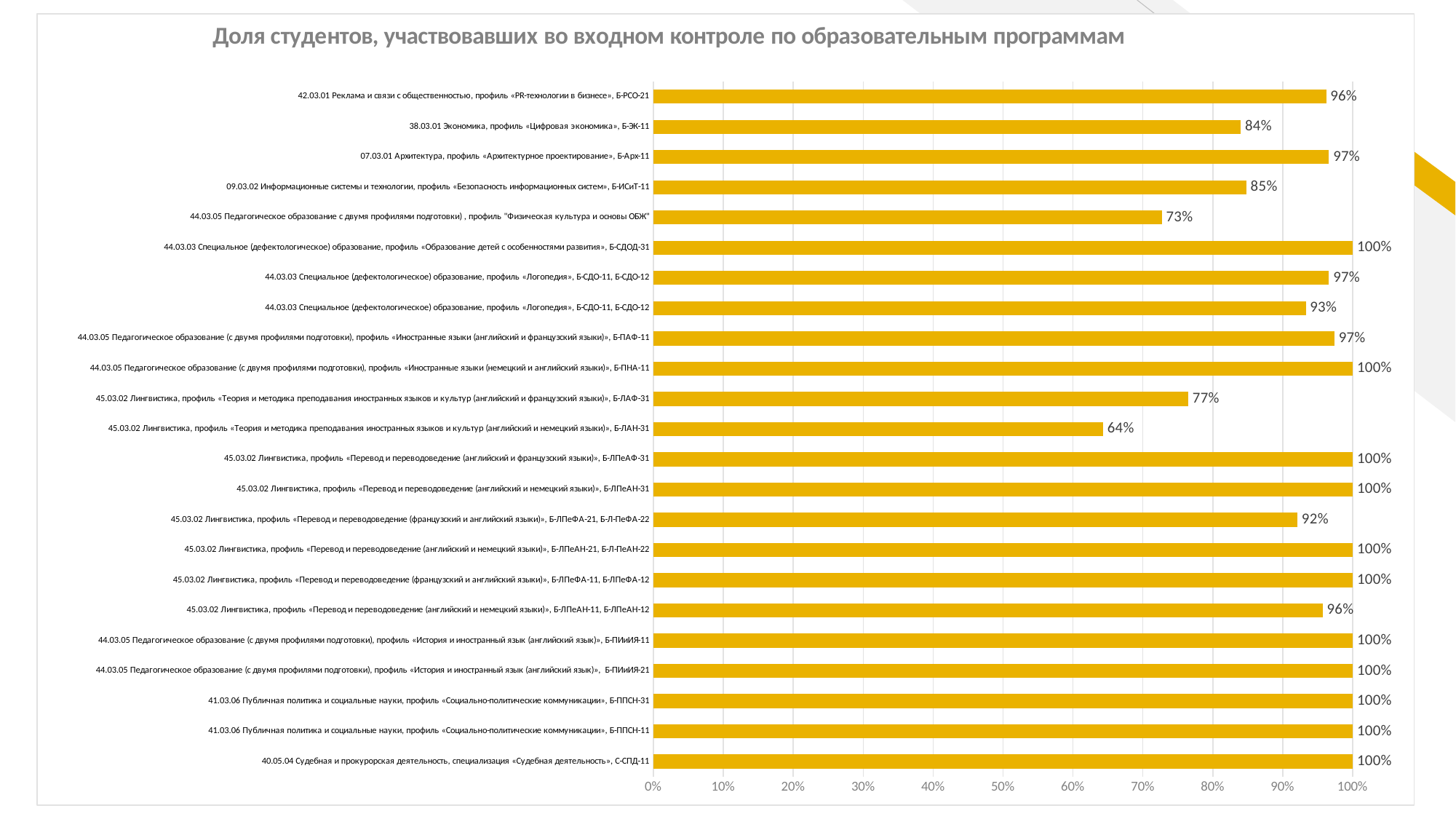
What is the value for Б-ЭК-11 (38.03.01 Экономика, профиль «Цифровая экономика»)? 84% What share of students is shown for Б-ИСиТ-11 (09.03.02 Информационные системы и технологии)? 85% What is the value for Б-ЛАФ-31 (45.03.02 Лингвистика, Теория и методика преподавания иностранных языков и культур, английский и французский языки)? 77% What is the value for Б-РСО-21 (42.03.01 Реклама и связи с общественностью)? 96% What type of chart is shown on the slide? bar chart Which educational program has the lowest share of students who took part in the entrance control? 45.03.02 Лингвистика, профиль «Теория и методика преподавания иностранных языков и культур (английский и немецкий языки)», Б-ЛАН-31 How many educational programs (bars) are shown in the chart? 23 What is the difference between the values for Б-Арх-11 (97%) and Б-ЭК-11 (84%)? 13% What is the title of the chart? Доля студентов, участвовавших во входном контроле по образовательным программам How many programs have a value of 100%? 11 Is the value for the program with профиль "Физическая культура и основы ОБЖ" greater or less than 80%? less Which has a higher value: Б-ЛПеФА-21, Б-Л-ПеФА-22 or Б-ЛПеАН-11, Б-ЛПеАН-12? Б-ЛПеАН-11, Б-ЛПеАН-12